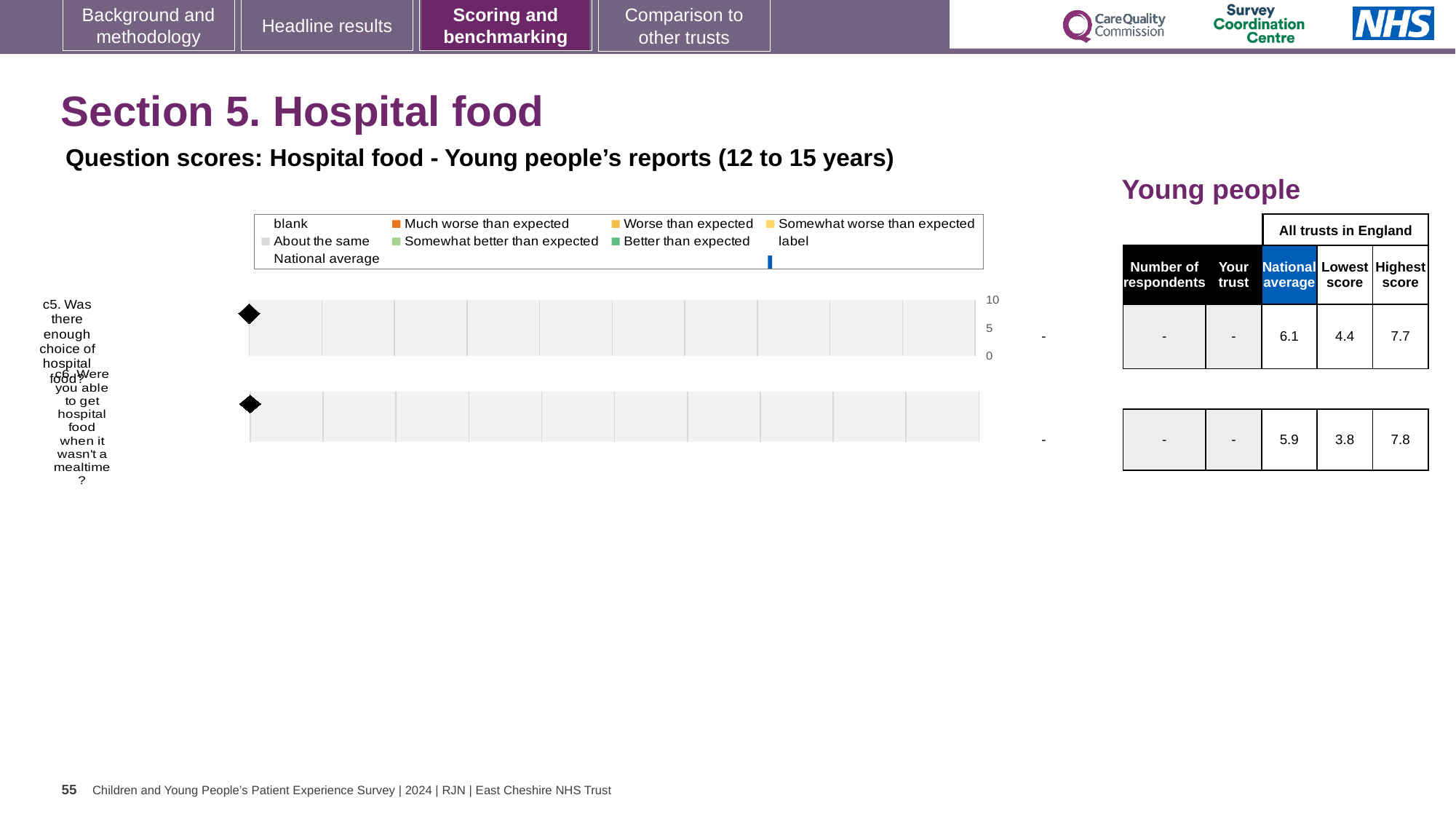
How many questions (categories) are plotted on the chart? 2 In the table, what is the national average score for c5 (Was there enough choice of hospital food?)? 6.1 In the table, what is shown as the trust's score for c5? - In the table, what is the highest score across all trusts in England for c6? 7.8 In the table, what is the lowest score across all trusts in England for c5? 4.4 What is the label of the first question plotted on the chart? c5. Was there enough choice of hospital food? In the table, what is the national average score for c6 (Were you able to get hospital food when it wasn't a mealtime?)? 5.9 In the table, what is the difference between the highest and lowest score for c6? 4.0 In the table, which question has the higher national average, c5 or c6? c5 What is the highest value shown on the chart's axis? 10 In the table, what is the difference between the highest and lowest score for c5? 3.3 What kind of chart is shown on the slide? bar chart